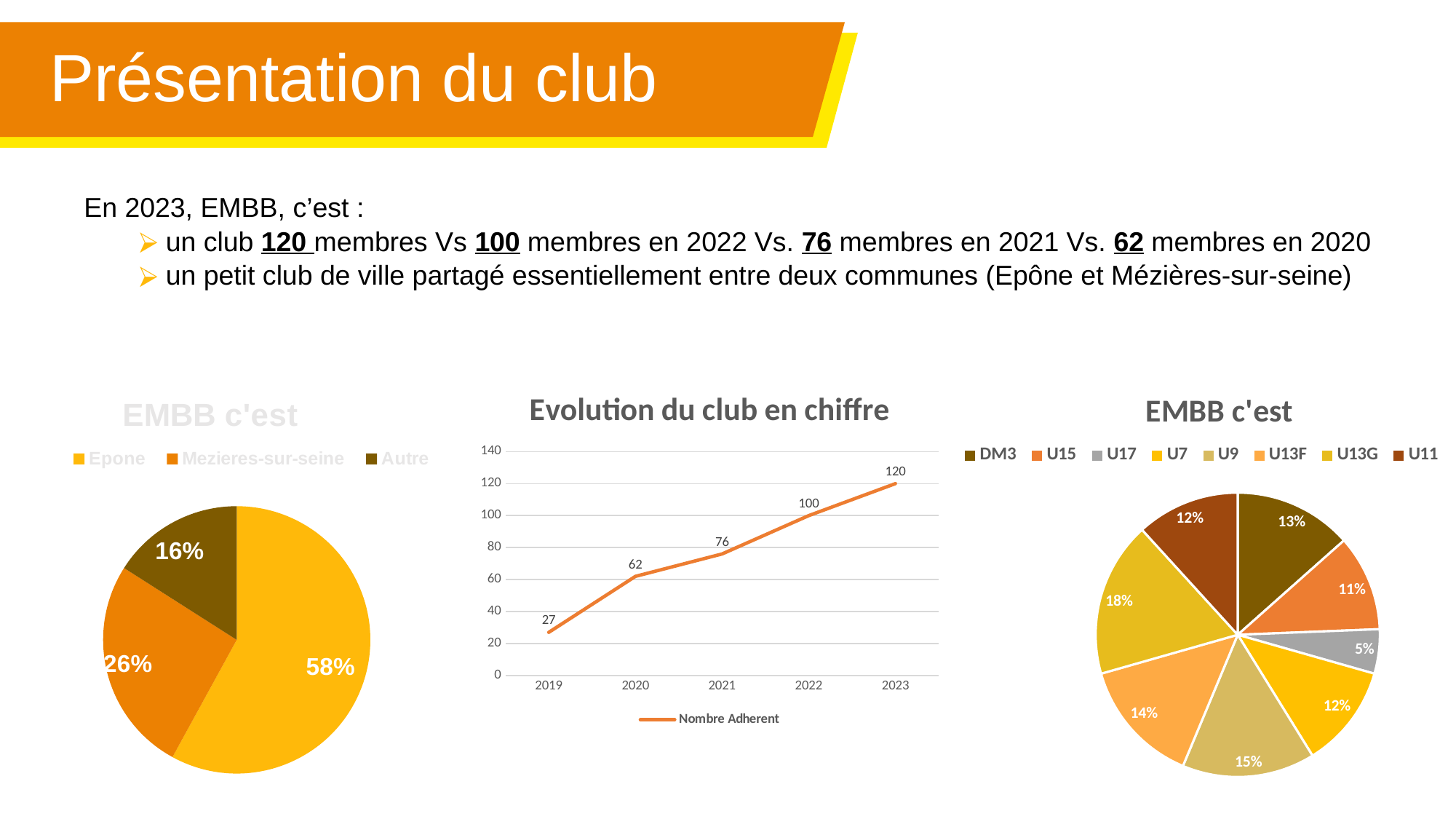
In the pie chart on the right of the slide, which category has the largest slice? U13G In the line chart titled 'Evolution du club en chiffre', what series name does the legend show? Nombre Adherent In the pie chart on the left of the slide, what share does Epone have? 58% In the pie chart on the right of the slide, what share does U17 have? 5% In the line chart titled 'Evolution du club en chiffre', do the values rise or fall from 2019 to 2023? rise In the line chart titled 'Evolution du club en chiffre', what is the value for 2021? 76 In the pie chart on the left of the slide, how many categories does the legend list? 3 In the line chart titled 'Evolution du club en chiffre', how many years are plotted on the x axis? 5 In the line chart titled 'Evolution du club en chiffre', what is the difference between the values for 2023 and 2022? 20 In the pie chart on the right of the slide, which is larger, the share for U9 or the share for U15? U9 In the line chart titled 'Evolution du club en chiffre', what is the value for 2019? 27 In the pie chart on the left of the slide, which category has the smallest slice? Autre